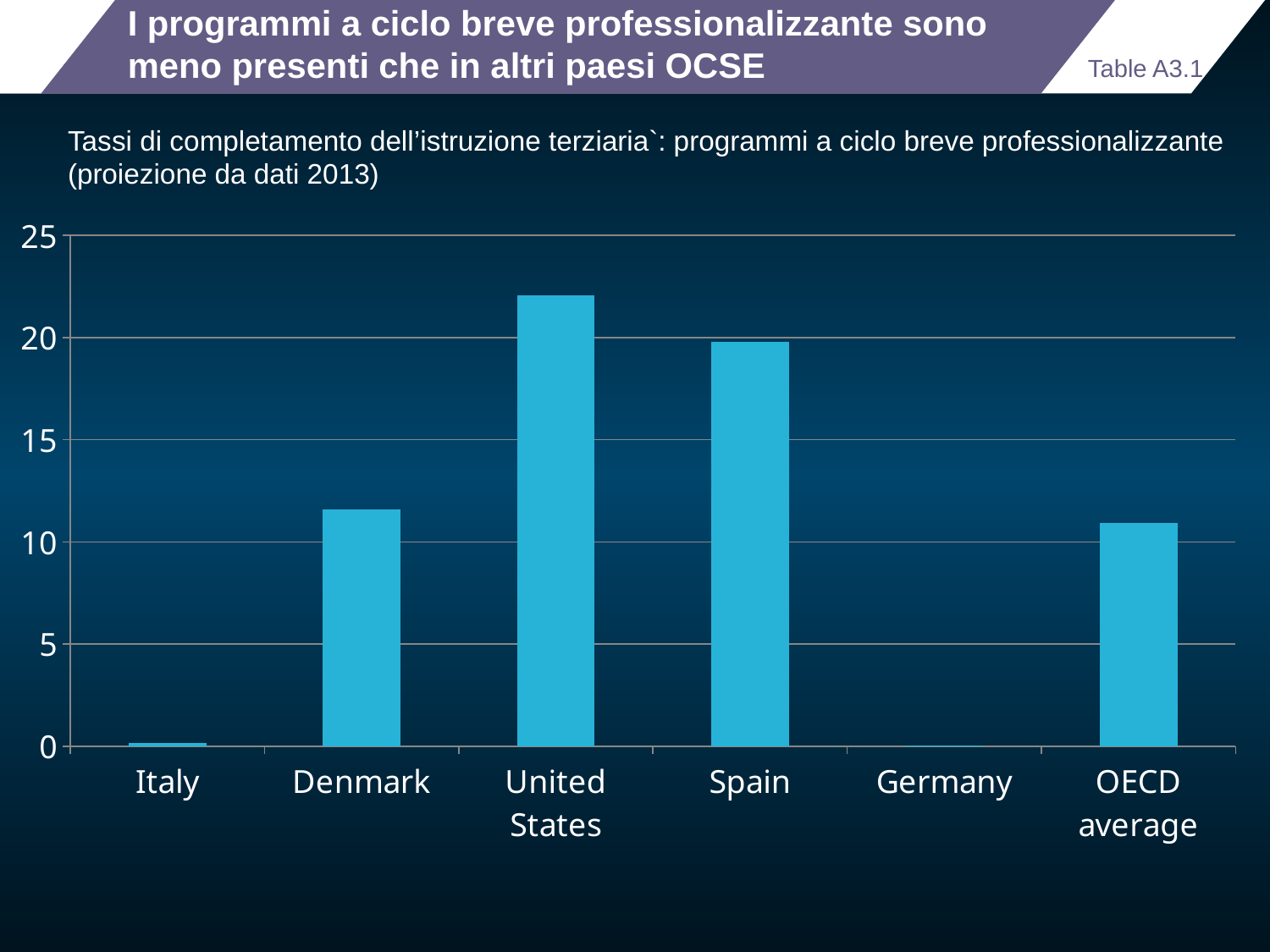
Is the value for Italy greater or less than 5? less Is the value for OECD average greater or less than 15? less Which table reference is shown in the top right corner of the slide? Table A3.1 Is the value for Denmark greater or less than 10? greater How many countries or categories are shown on the x axis of the chart? 6 Which category has the highest bar in the chart? United States Which is larger, the value for Denmark or the value for Spain? Spain Which is larger, the value for United States or the value for Spain? United States What kind of chart is shown on the slide? bar chart